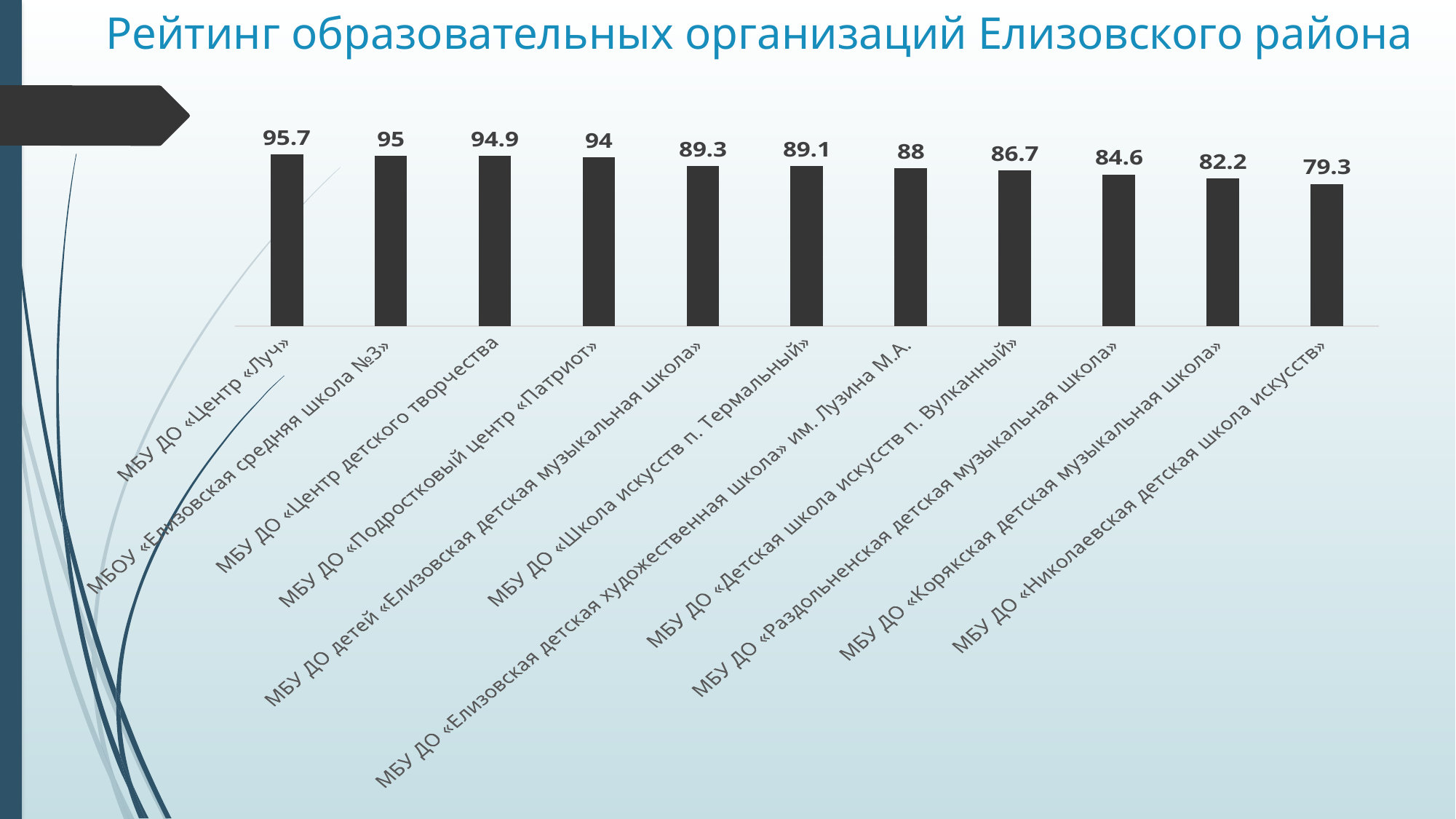
Which organisation has the highest value in the chart? МБУ ДО «Центр «Луч» Which has a larger value: МБУ ДО «Подростковый центр «Патриот» or МБУ ДО «Детская школа искусств п. Вулканный»? МБУ ДО «Подростковый центр «Патриот» Which organisation has the lowest value in the chart? МБУ ДО «Николаевская детская школа искусств» What type of chart is shown on the slide? Bar chart What is the difference between the values for МБОУ «Елизовская средняя школа №3» and МБУ ДО «Раздольненская детская музыкальная школа»? 10.4 What is the difference between the values for МБУ ДО «Центр «Луч» and МБУ ДО «Николаевская детская школа искусств»? 16.4 Do the values rise or fall from left to right across the chart? Fall How many organisations (bars) are shown in the chart? 11 What is the value for МБУ ДО «Корякская детская музыкальная школа»? 82.2 What is the value for МБУ ДО «Школа искусств п. Термальный»? 89.1 What is the value for МБУ ДО «Центр «Луч»? 95.7 What is the title of the chart on the slide? Рейтинг образовательных организаций Елизовского района